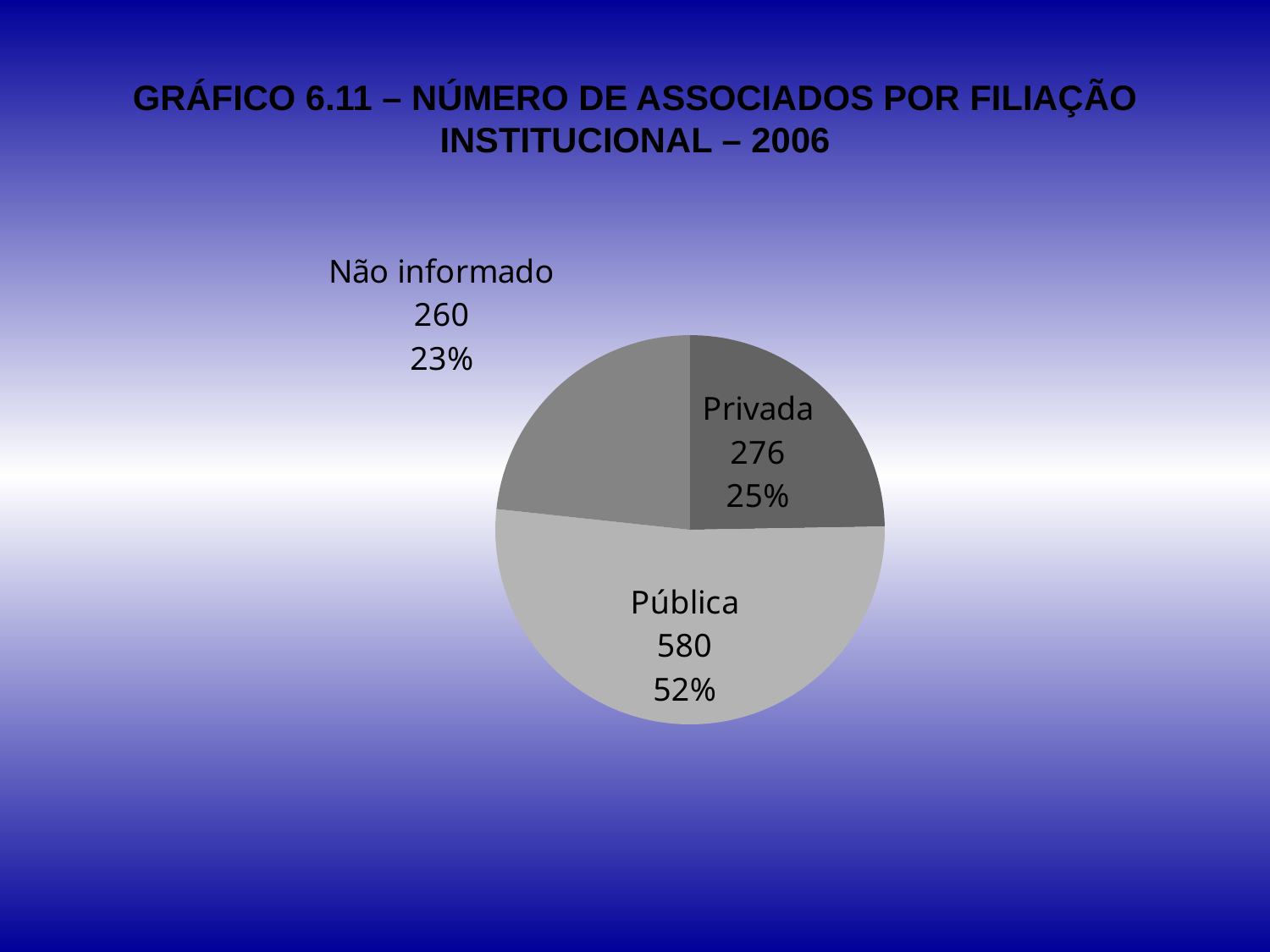
Which category has the smallest number of associates? Não informado What is the number of associates for Pública? 580 Which is larger, the value for Privada or the value for Não informado? Privada What share of the pie does Pública represent? 52% What kind of chart is shown on the slide? pie chart What is the number of associates for Privada? 276 What is the number of associates for Não informado? 260 What share of the pie does Não informado represent? 23% What is the title of the chart? GRÁFICO 6.11 – NÚMERO DE ASSOCIADOS POR FILIAÇÃO INSTITUCIONAL – 2006 How many slices does the pie chart have? 3 What is the difference between the number of associates for Pública and Privada? 304 Which category has the largest number of associates? Pública